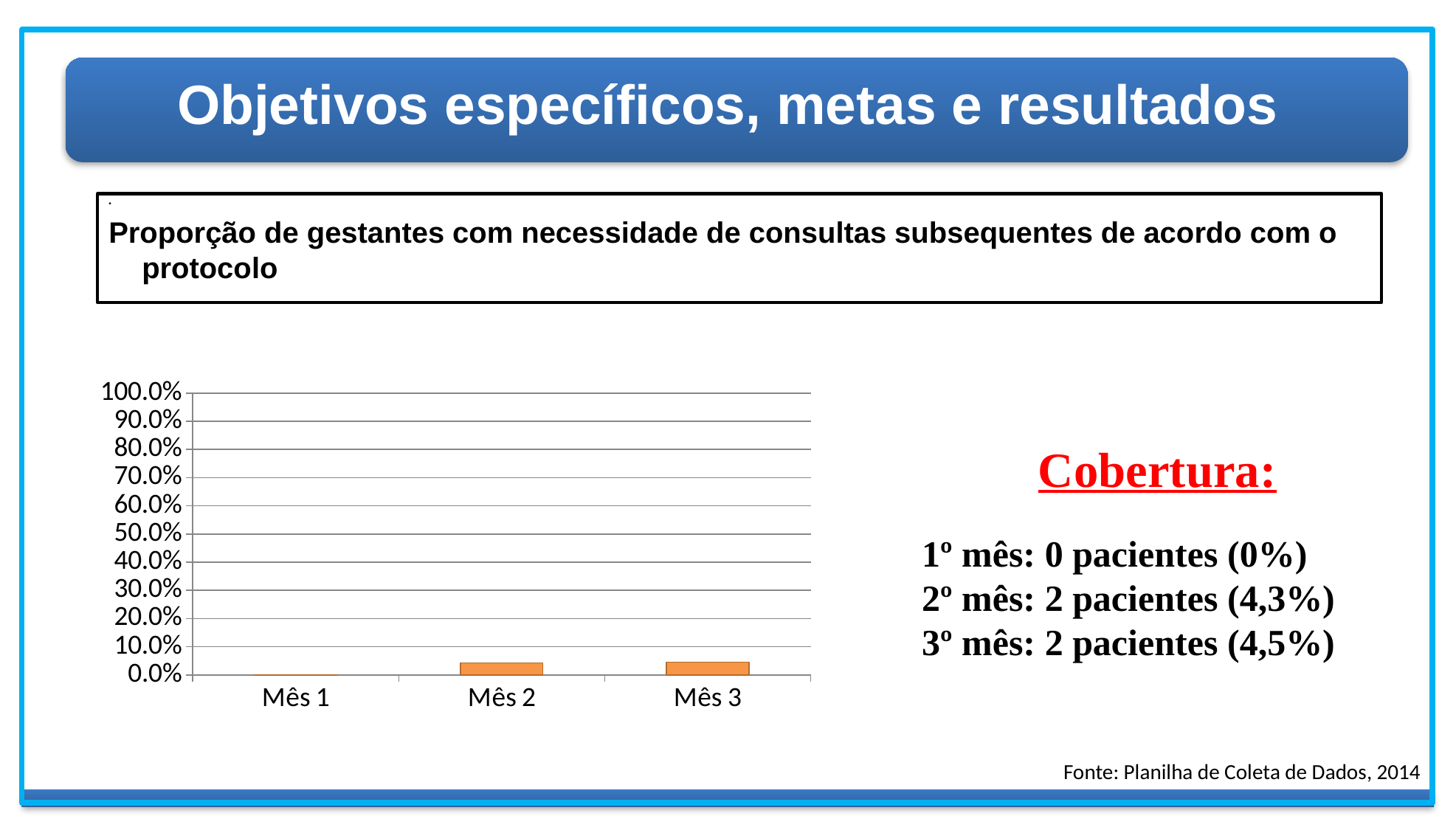
What is the highest value shown on the y axis of the chart? 100.0% How many categories (months) are shown on the x axis of the chart? 3 Which month has the lowest value in the chart? Mês 1 Which is larger, the value for Mês 1 or the value for Mês 2? Mês 2 What is the value for Mês 1 in the chart? 0.0% Is the value for Mês 2 greater or less than 10.0%? less What kind of chart is shown on the slide? bar chart Which is larger, the value for Mês 1 or the value for Mês 3? Mês 3 What colour are the bars in the chart? orange Do the values rise or fall from Mês 1 to Mês 3? rise Is the value for Mês 3 greater or less than 10.0%? less